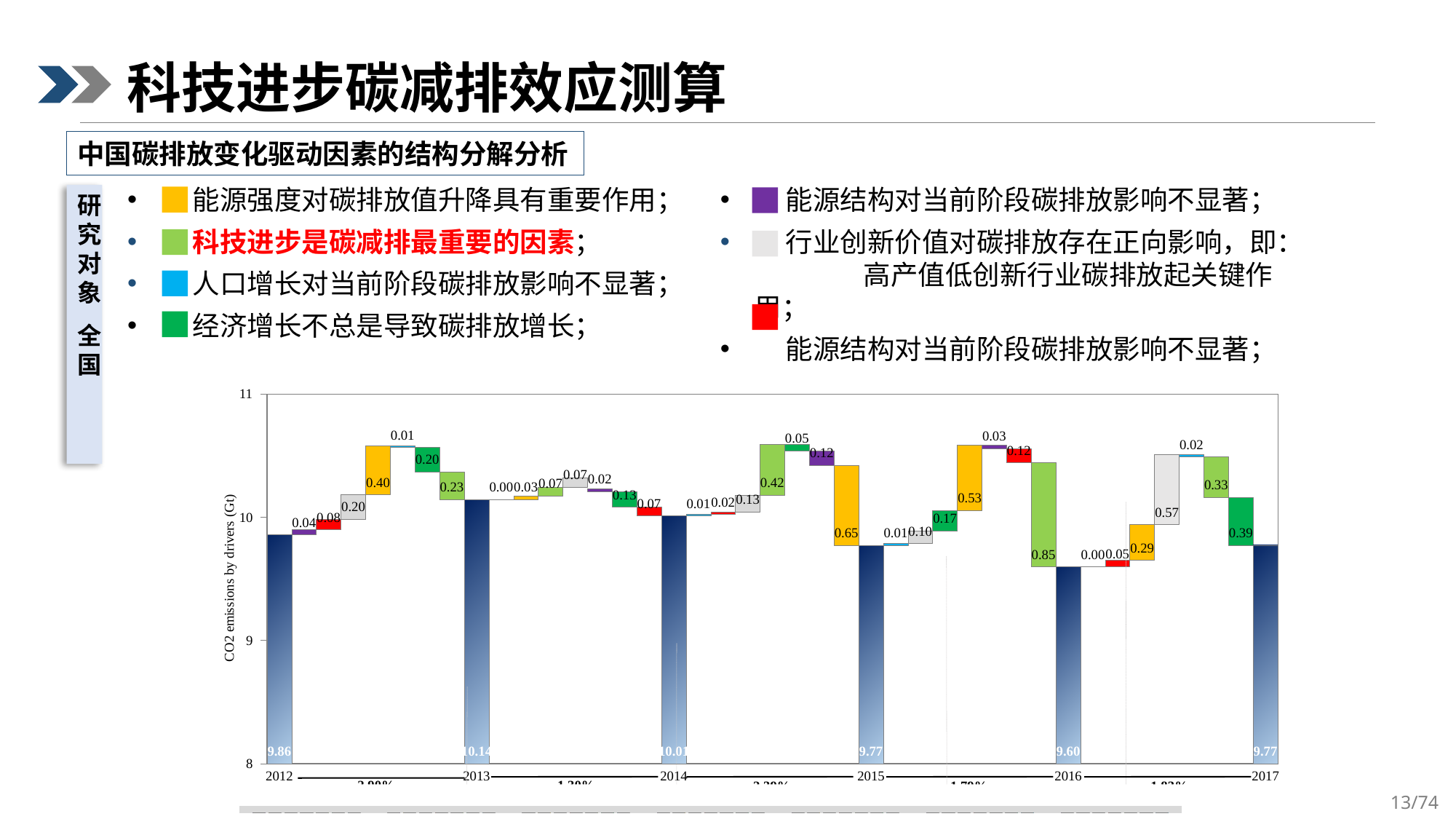
How many year bars (total emissions bars) are shown on the chart? 6 What is the difference between the 2013 and 2012 CO2 emissions values? 0.28 What is the CO2 emissions value labelled on the 2012 bar? 9.86 Which year has the larger CO2 emissions value, 2014 or 2015? 2014 What kind of chart is shown on the slide? bar chart Which year has the highest CO2 emissions value among the labelled year bars? 2013 What is the CO2 emissions value labelled on the 2016 bar? 9.60 Which year has the lowest CO2 emissions value among the labelled year bars? 2016 What is the label on the vertical axis of the chart? CO2 emissions by drivers (Gt) What is the difference between the 2015 and 2016 CO2 emissions values? 0.17 What is the CO2 emissions value labelled on the 2013 bar? 10.14 Is the CO2 emissions value for 2016 greater or less than 10? less